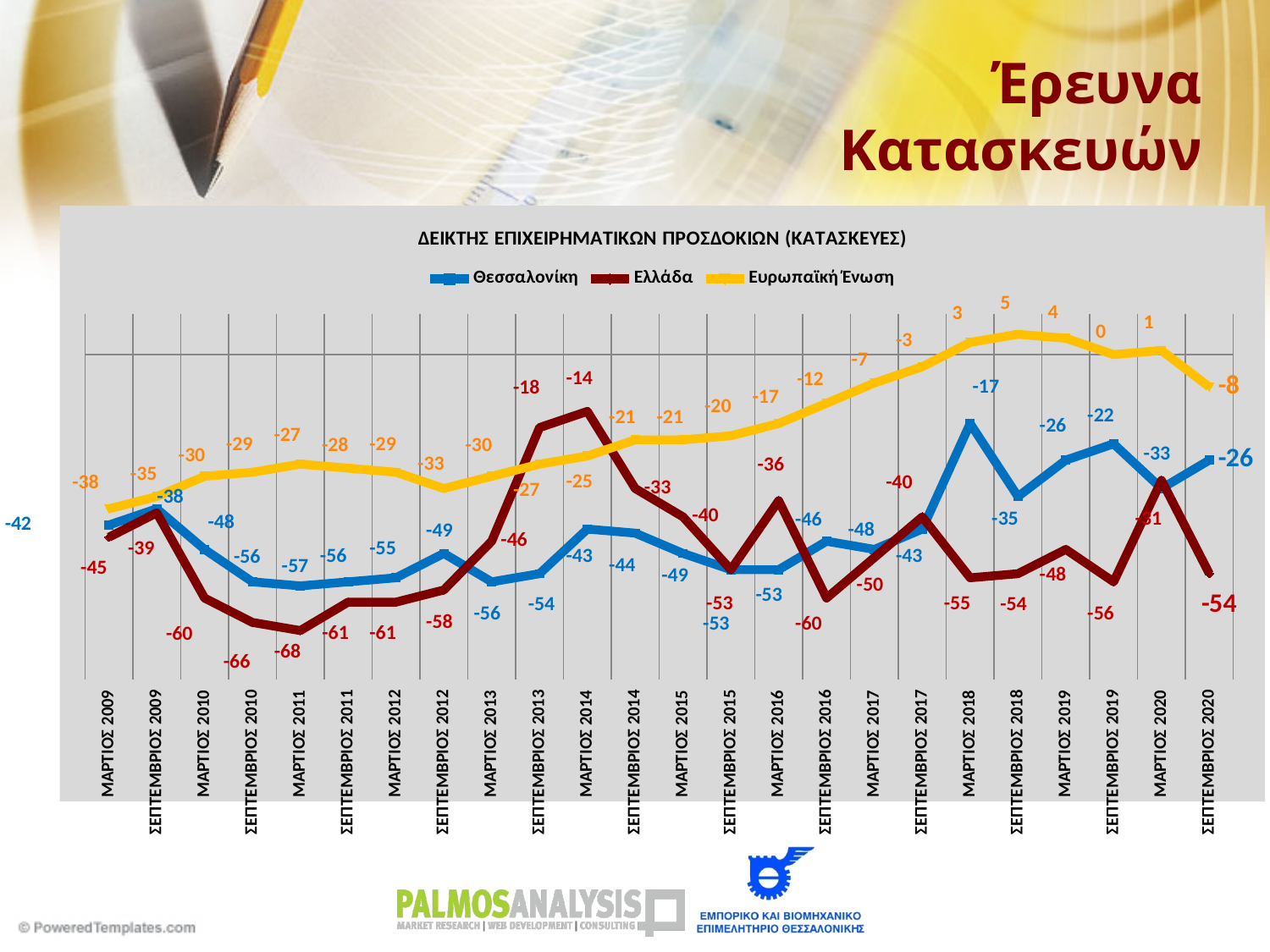
In which period does the Θεσσαλονίκη series reach its highest value? ΜΑΡΤΙΟΣ 2018 How many time periods are plotted on the x axis? 24 What is the value for Θεσσαλονίκη in ΜΑΡΤΙΟΣ 2018? -17 What is the difference between the Θεσσαλονίκη and Ελλάδα values in ΣΕΠΤΕΜΒΡΙΟΣ 2020? 28 What is the value for Ελλάδα in ΜΑΡΤΙΟΣ 2011? -68 In ΜΑΡΤΙΟΣ 2014, which series has the higher value, Ελλάδα or Θεσσαλονίκη? Ελλάδα How many series does the legend list? 3 In which period does the Ελλάδα series reach its lowest value? ΜΑΡΤΙΟΣ 2011 Which series is drawn in yellow? Ευρωπαϊκή Ένωση In which period does the Ευρωπαϊκή Ένωση series reach its highest value? ΣΕΠΤΕΜΒΡΙΟΣ 2018 What kind of chart is shown on the slide? line chart What is the value for Ευρωπαϊκή Ένωση in ΣΕΠΤΕΜΒΡΙΟΣ 2020? -8